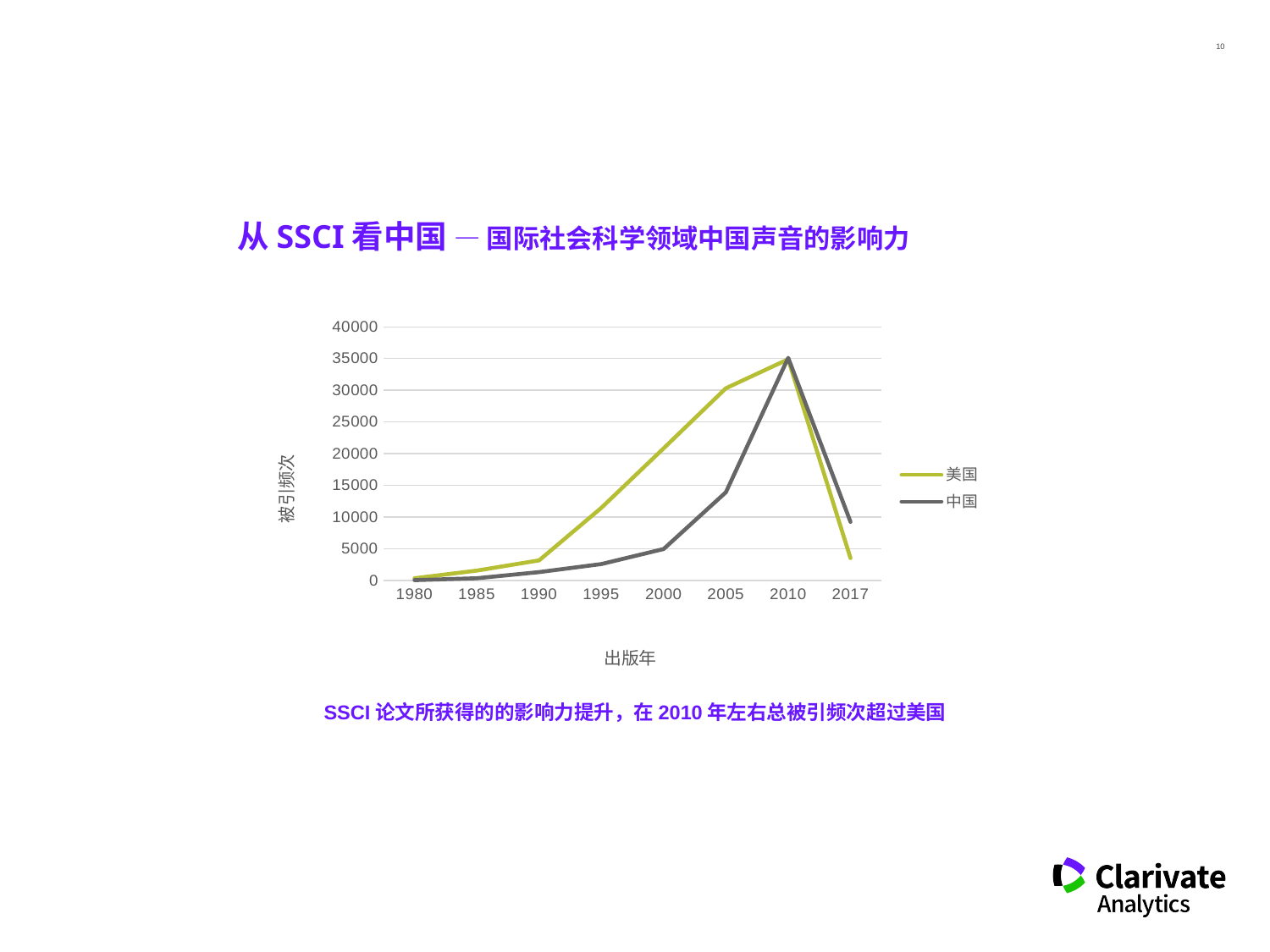
Is the value for 中国 in 2017 greater or less than 5000? greater How many years are marked on the x axis? 8 How many series does the legend list? 2 Is the value for 美国 in 2005 greater or less than 25000? greater In which year does the 中国 series reach its highest value? 2010 In which year does the 美国 series reach its highest value? 2010 What is the label of the x axis? 出版年 In 2000, which series has the larger value, 美国 or 中国? 美国 What kind of chart is shown on the slide? line chart Which series is shown in the yellow-green line? 美国 In 2017, which series has the larger value, 美国 or 中国? 中国 Is the value for 中国 in 2005 greater or less than 15000? less